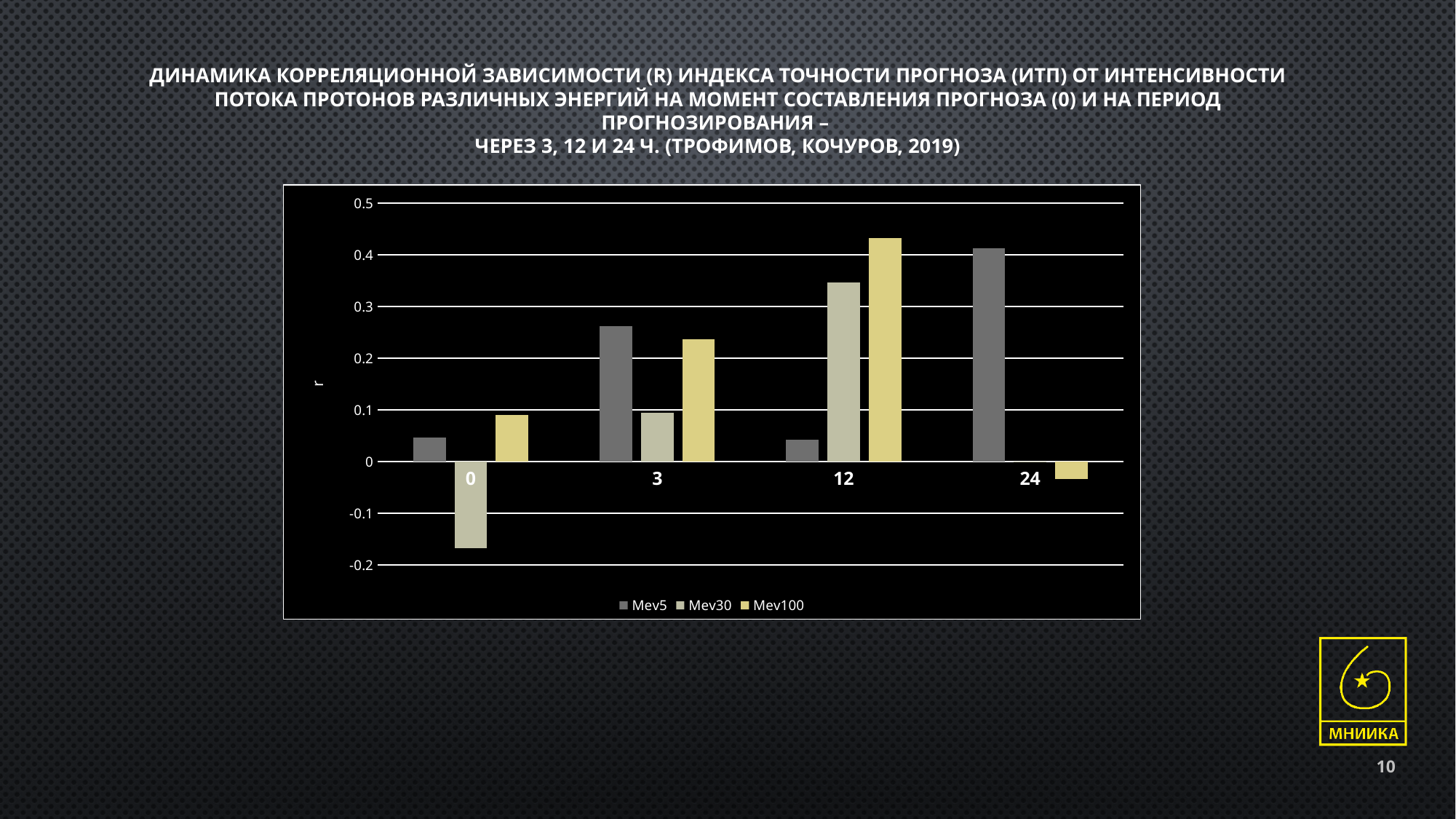
Is the value for Mev5 at category 3 greater or less than 0.2? greater How many series does the legend list? 3 What is the label on the vertical axis of the chart? r Which series has the lowest value at category 0? Mev30 Is the value for Mev5 at category 24 greater or less than 0.3? greater How many categories are shown on the x axis? 4 Which is larger at category 3: the value for Mev5 or the value for Mev30? Mev5 Is the value for Mev30 at category 0 greater or less than -0.1? less Which category has the highest value for the Mev5 series? 24 What kind of chart is shown on the slide? bar chart Which series has the highest value at category 12? Mev100